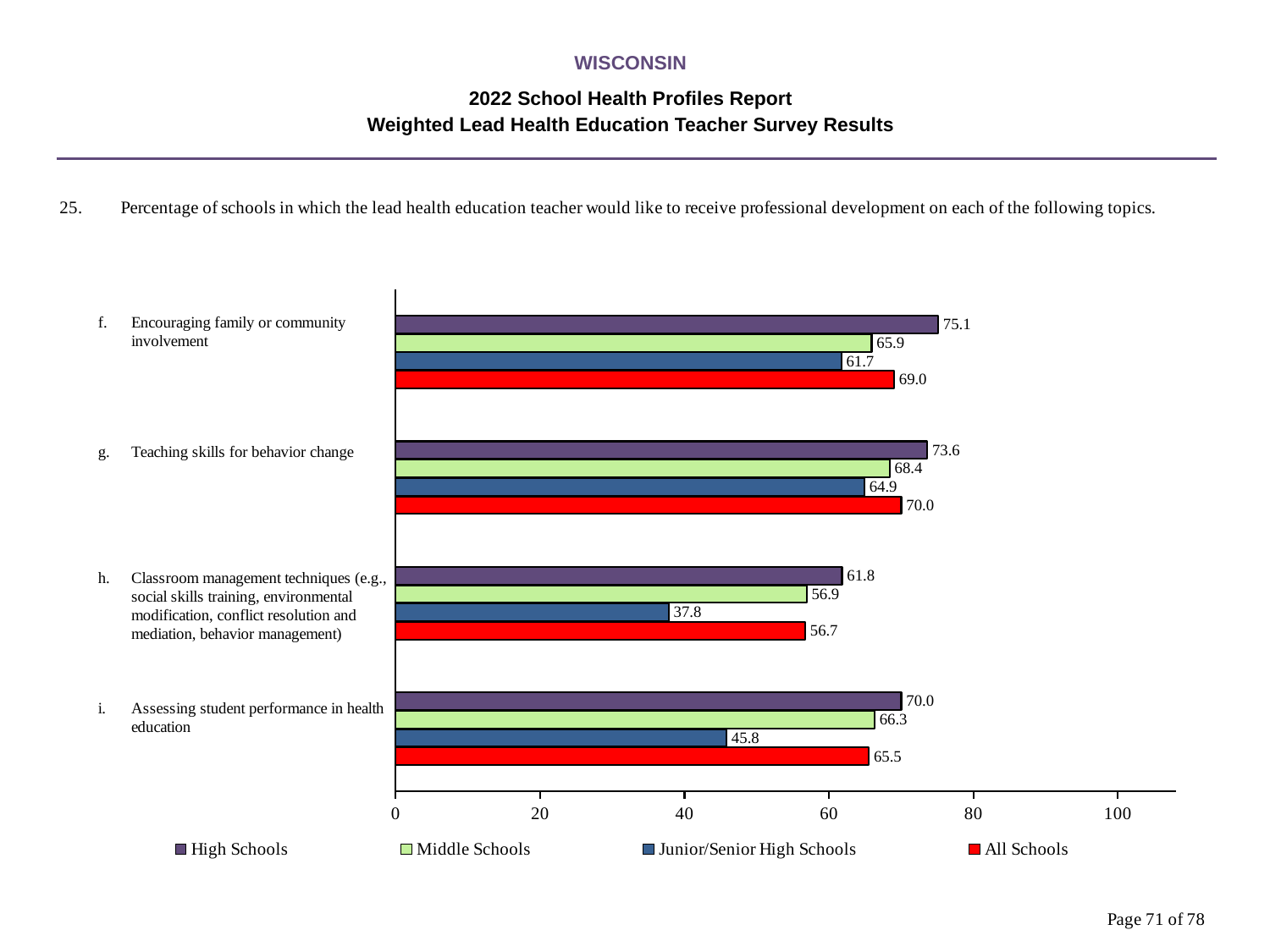
What kind of chart is shown on the slide? Bar chart Which topic has the highest value for High Schools? Encouraging family or community involvement What colour are the All Schools bars? Red What is the value for High Schools for 'Encouraging family or community involvement'? 75.1 What is the value for Junior/Senior High Schools for 'Classroom management techniques'? 37.8 What is the value for Middle Schools for 'Assessing student performance in health education'? 66.3 What is the value for All Schools for 'Teaching skills for behavior change'? 70.0 How many topics are shown on the chart? 4 What is the difference between the High Schools and Junior/Senior High Schools values for 'Assessing student performance in health education'? 24.2 Which topic has the lowest value for Junior/Senior High Schools? Classroom management techniques How many series does the legend list? 4 Which is larger for 'Teaching skills for behavior change': the Middle Schools value or the Junior/Senior High Schools value? Middle Schools